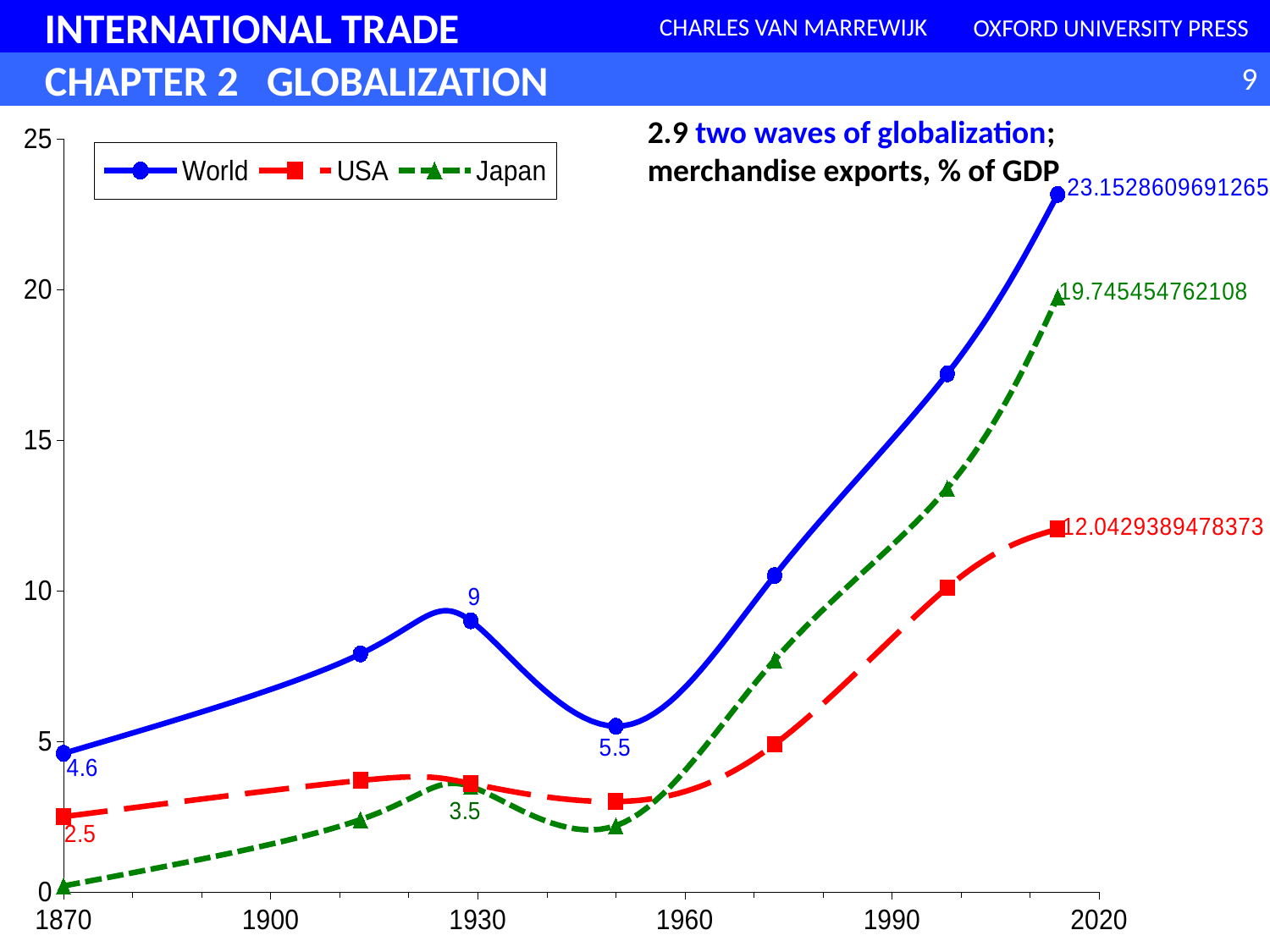
At 1870, which is larger: the World value or the USA value? World How many series does the legend list? 3 Is the value of the Japan series at 1870 greater or less than 5? less What is the value printed at the last point of the USA series? 12.0429389478373 What kind of chart is shown on the slide? line chart Which series has the highest value at its last point? World What is the value of the World series at 1870? 4.6 What is the difference between the World value (4.6) and the USA value (2.5) at 1870? 2.1 What is the value printed at the last point of the World series? 23.1528609691265 Does the World series rise or fall between its point labelled 9 and its point labelled 5.5? fall What is the value printed at the last point of the Japan series? 19.745454762108 What is the value of the USA series at 1870? 2.5